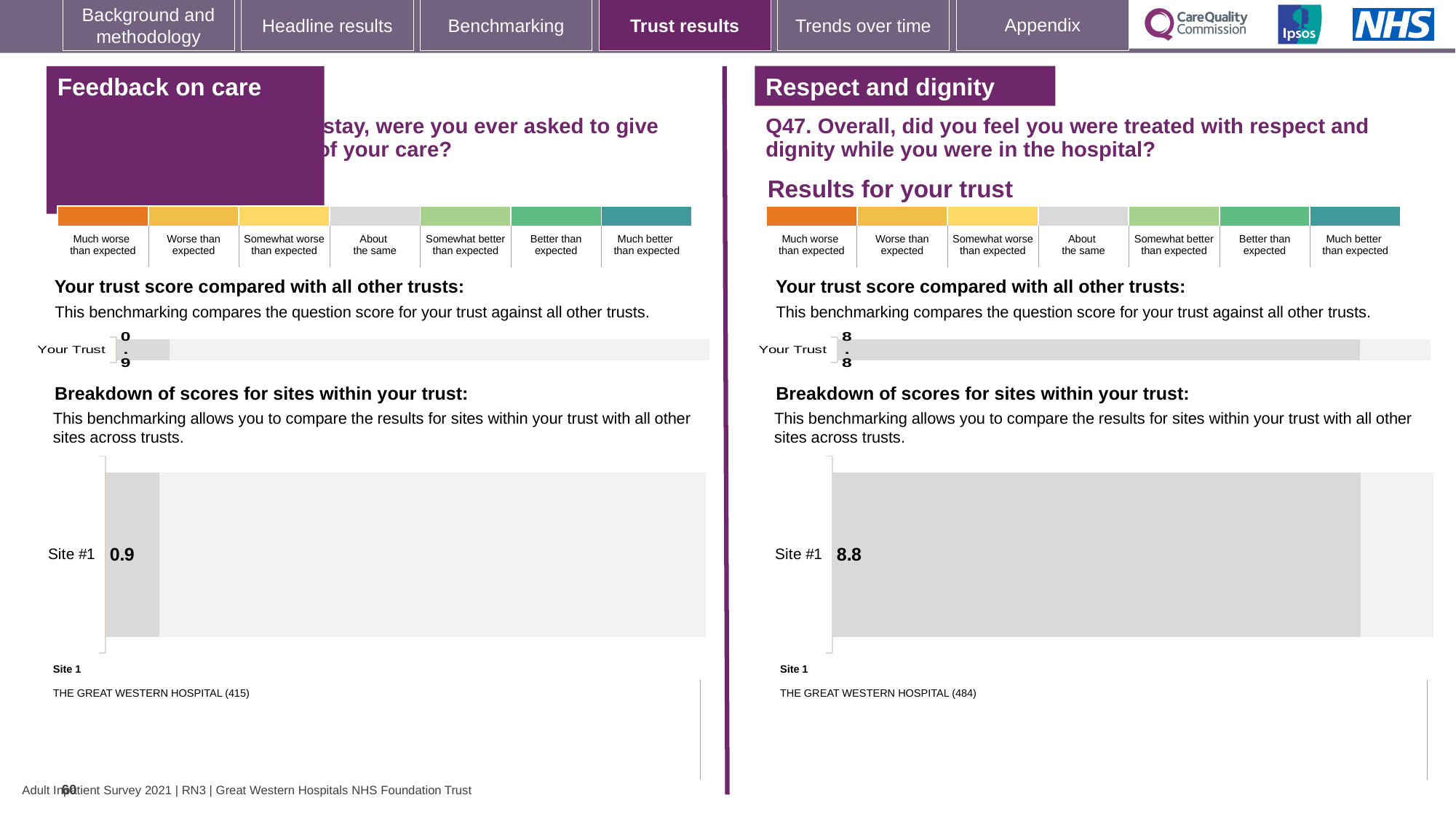
In the Respect and dignity section, what is the Your Trust score shown in the 'Your trust score compared with all other trusts' chart? 8.8 What type of chart is used to show the Site #1 score in the Respect and dignity section? Bar chart In the Respect and dignity section, what score is shown for Site #1 in the 'Breakdown of scores for sites within your trust' chart? 8.8 In the Feedback on care section, which site name is listed as Site 1 below the breakdown chart? THE GREAT WESTERN HOSPITAL (415) In the Respect and dignity section, which site name is listed as Site 1 below the breakdown chart? THE GREAT WESTERN HOSPITAL (484) What is the difference between the Site #1 score in the Respect and dignity section and the Site #1 score in the Feedback on care section? 7.9 In the Feedback on care section, what is the Your Trust score shown in the 'Your trust score compared with all other trusts' chart? 0.9 What type of chart is used to show the Your Trust score in the Feedback on care section? Bar chart How many sites are shown in the 'Breakdown of scores for sites within your trust' chart in the Respect and dignity section? 1 How many sites are shown in the 'Breakdown of scores for sites within your trust' chart in the Feedback on care section? 1 In the Feedback on care section, what score is shown for Site #1 in the 'Breakdown of scores for sites within your trust' chart? 0.9 Which is larger: the Site #1 score in the Feedback on care section or the Site #1 score in the Respect and dignity section? Respect and dignity